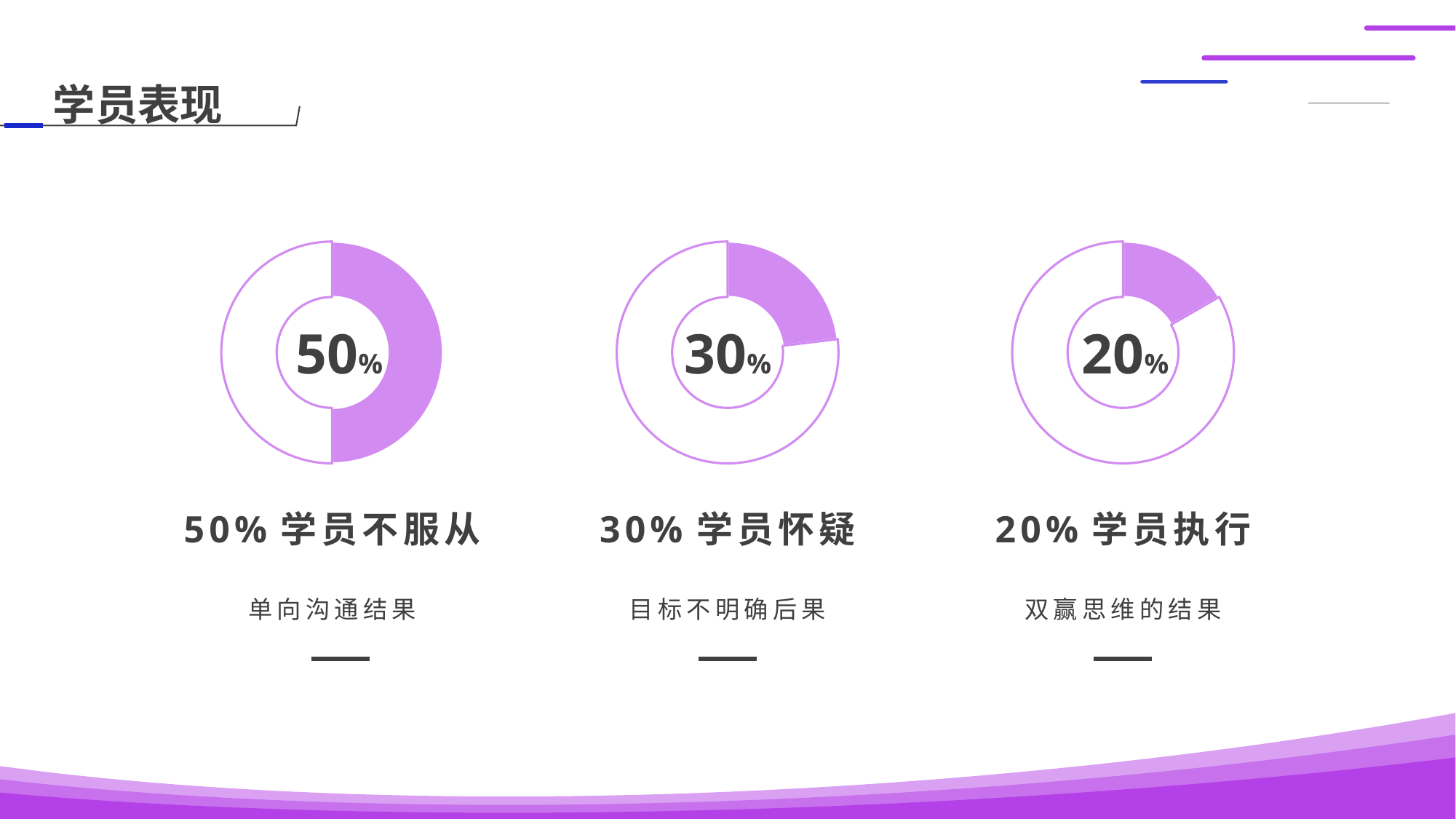
Which of the three donut charts shows the lowest percentage? The right chart (20% 学员执行) Which of the three donut charts shows the highest percentage? The left chart (50% 学员不服从) How many donut charts are shown on the slide? 3 What type of chart is used to display the percentages on the slide? Donut (pie) chart What value is shown in the centre of the left donut chart? 50% What percentage of students is labelled as 学员不服从 on the slide? 50% What value is shown in the centre of the right donut chart? 20% What is the difference between the value in the middle donut chart and the value in the right donut chart? 10% What percentage of students is labelled as 学员执行 on the slide? 20% What value is shown in the centre of the middle donut chart? 30% Which is larger, the value in the middle donut chart or the value in the right donut chart? The middle chart (30%) What is the difference between the value in the left donut chart and the value in the middle donut chart? 20%